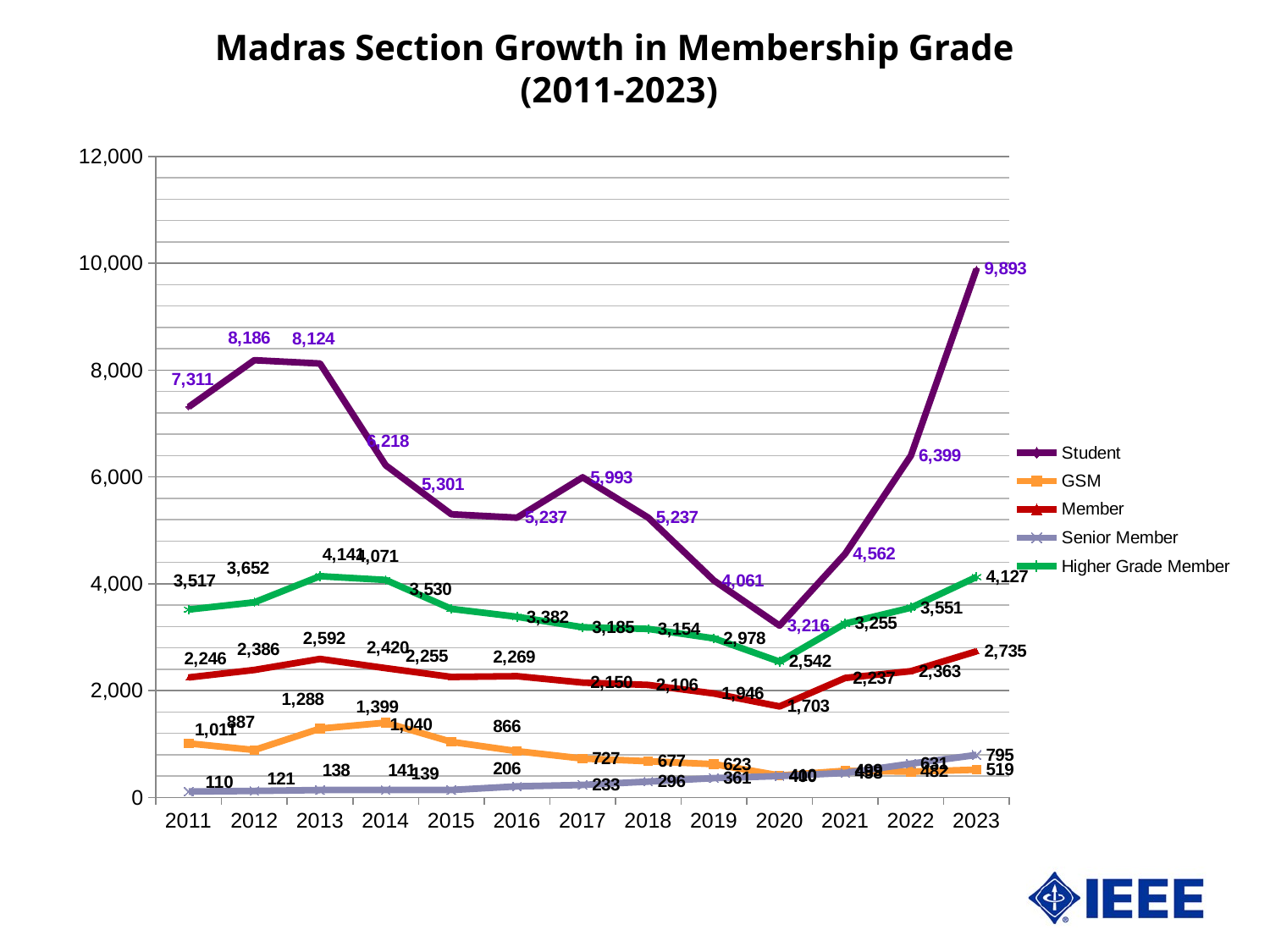
What is the Member value in 2020? 1,703 What is the GSM value in 2014? 1,399 How many series does the legend list? 5 What kind of chart is shown on the slide? Line chart In which year is the Student series at its highest? 2023 In 2013, which is larger: Higher Grade Member or Member? Higher Grade Member By how much did the Student value increase from 2022 to 2023? 3,494 What is the Higher Grade Member value in 2020? 2,542 How many years are plotted along the x axis? 13 In which year is the Student series at its lowest? 2020 Does the Senior Member series generally rise or fall from 2011 to 2023? Rise What is the Student value in 2023? 9,893